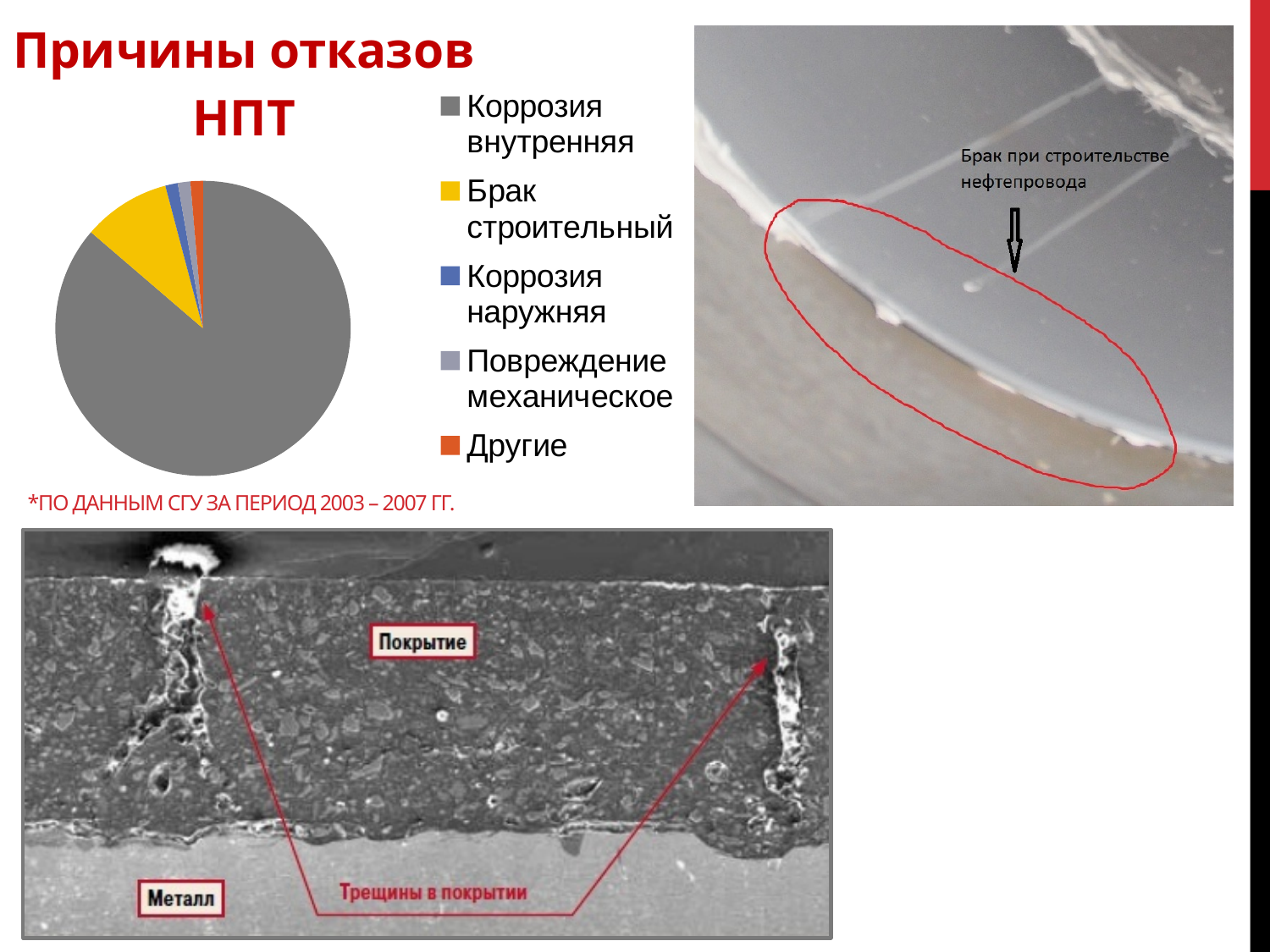
How many entries does the legend of the pie chart list? 5 Which category has the largest slice in the pie chart? Коррозия внутренняя Which category has the second-largest slice in the pie chart? Брак строительный Which slice is larger in the pie chart: Брак строительный or Другие? Брак строительный How many categories (slices) does the pie chart have? 5 What kind of chart is shown on the slide? Pie chart Which slice is larger in the pie chart: Коррозия внутренняя or Брак строительный? Коррозия внутренняя What colour is the slice for Брак строительный in the pie chart? Yellow What is the title of the pie chart? Причины отказов НПТ